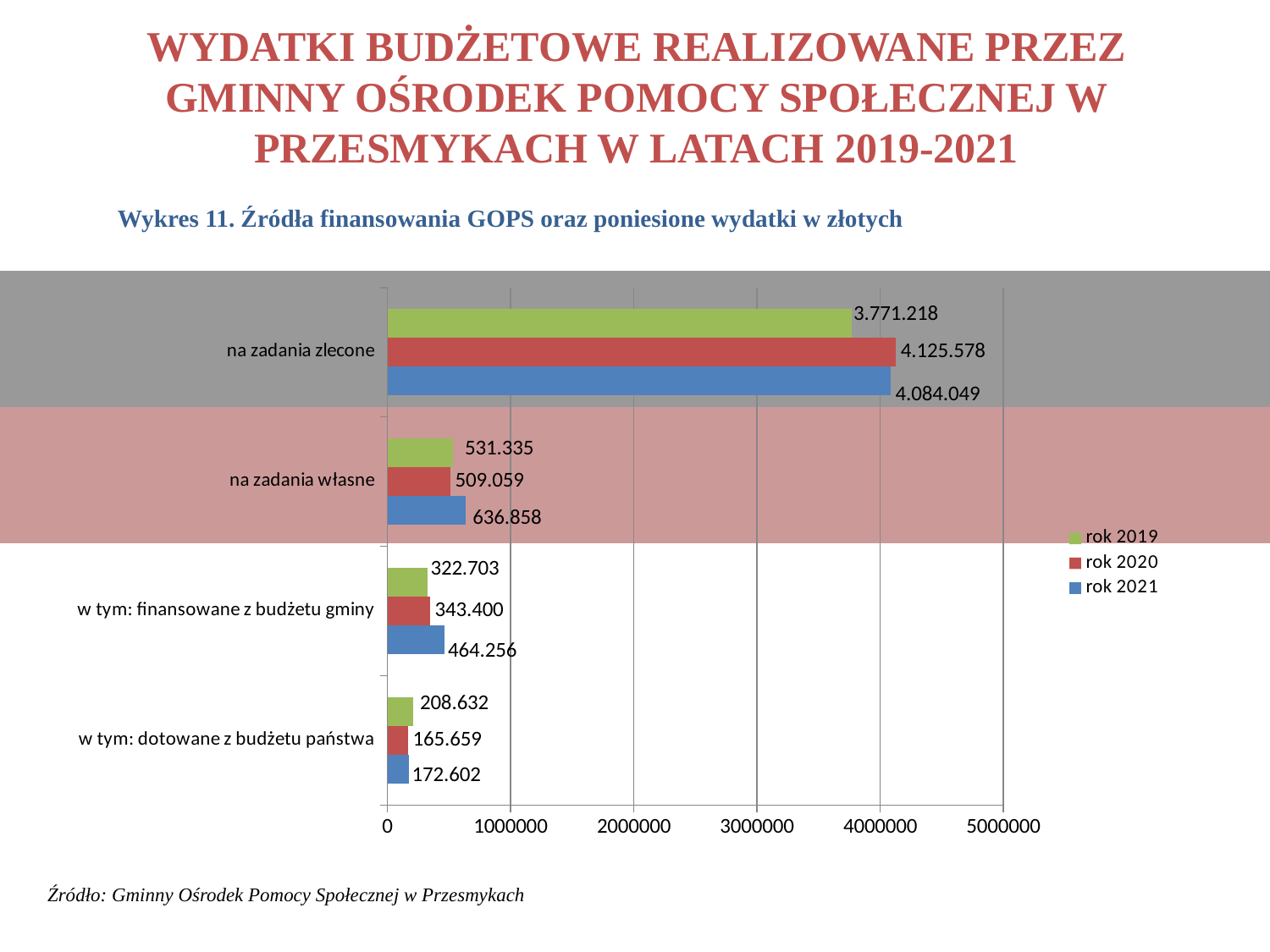
What is the value for 'na zadania własne' in the series 'rok 2021'? 636.858 How many series does the legend list? 3 Which category has the highest value in the series 'rok 2021'? na zadania zlecone What is the value for 'w tym: finansowane z budżetu gminy' in the series 'rok 2019'? 322.703 Which category has the lowest value in the series 'rok 2019'? w tym: dotowane z budżetu państwa What kind of chart is shown on the slide? bar chart Is the value for 'na zadania zlecone' in the series 'rok 2021' greater or less than 4000000? greater For 'na zadania własne', which series has the larger value: 'rok 2019' or 'rok 2020'? rok 2019 For 'na zadania zlecone', what is the difference between the 'rok 2020' value and the 'rok 2019' value? 354.360 What is the value for 'w tym: dotowane z budżetu państwa' in the series 'rok 2020'? 165.659 How many categories are shown on the chart? 4 What is the value for 'na zadania zlecone' in the series 'rok 2020'? 4.125.578